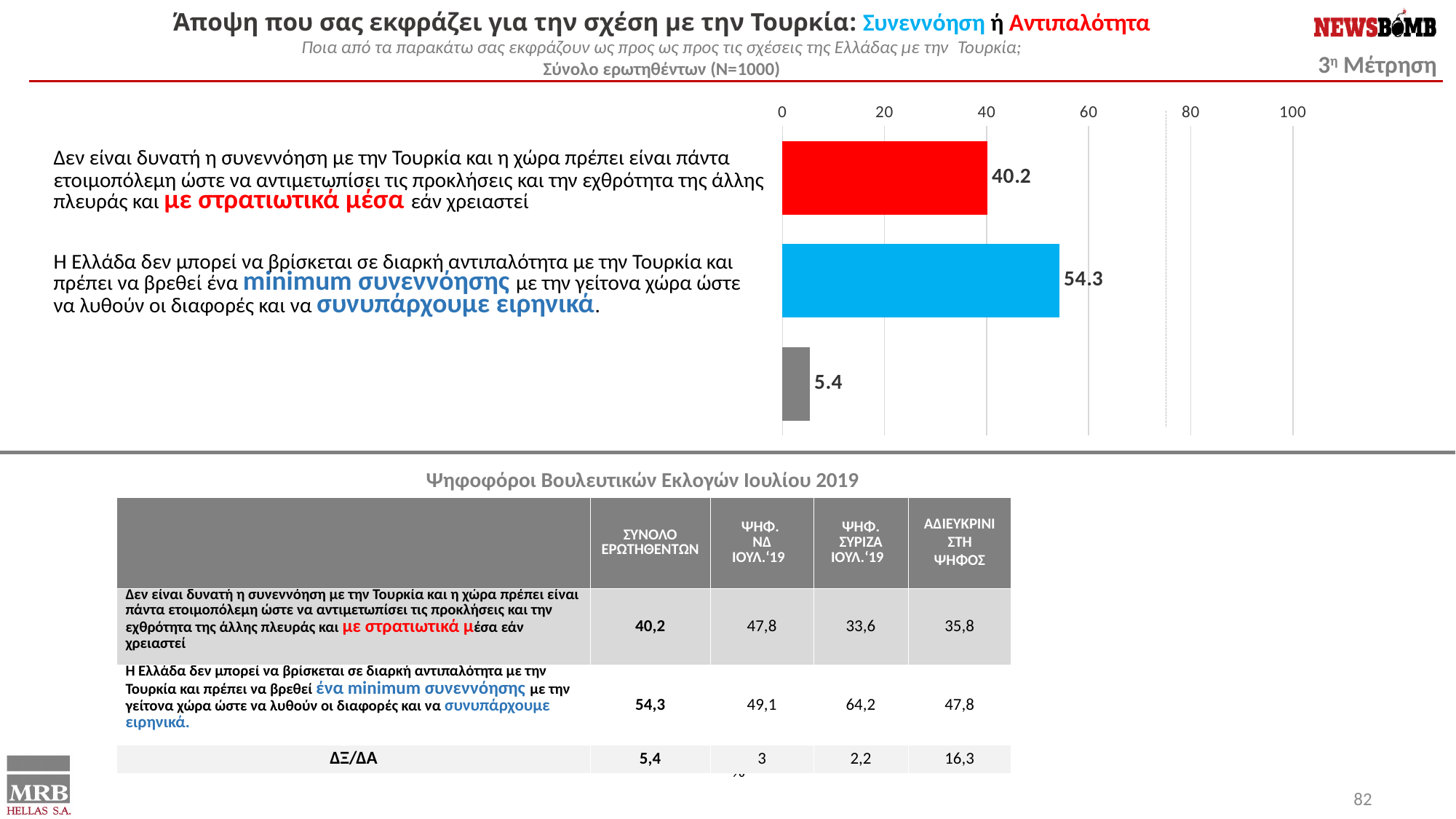
What is the value of the red bar, for the statement that understanding with Turkey is not possible and the country must be ready to respond with military means? 40.2 How many bars does the chart contain? 3 What is the value of the grey bar at the bottom of the chart? 5.4 What is the maximum value shown on the chart's horizontal axis? 100 Which bar has the lowest value in the chart? the grey bar (5.4) What is the value of the blue bar, for the statement that Greece must find a minimum understanding with Turkey and coexist peacefully? 54.3 Is the value of the red bar greater or less than 40? greater Which bar has the highest value in the chart? the blue bar (minimum συνεννόησης / συνυπάρχουμε ειρηνικά) What colour is the bar for the statement about finding a minimum understanding with Turkey? blue Which is larger: the value for the 'military means' statement or the value for the 'minimum understanding' statement? the 'minimum understanding' statement (54.3) What kind of chart is shown on the slide? bar chart What is the difference between the blue bar (54.3) and the red bar (40.2)? 14.1